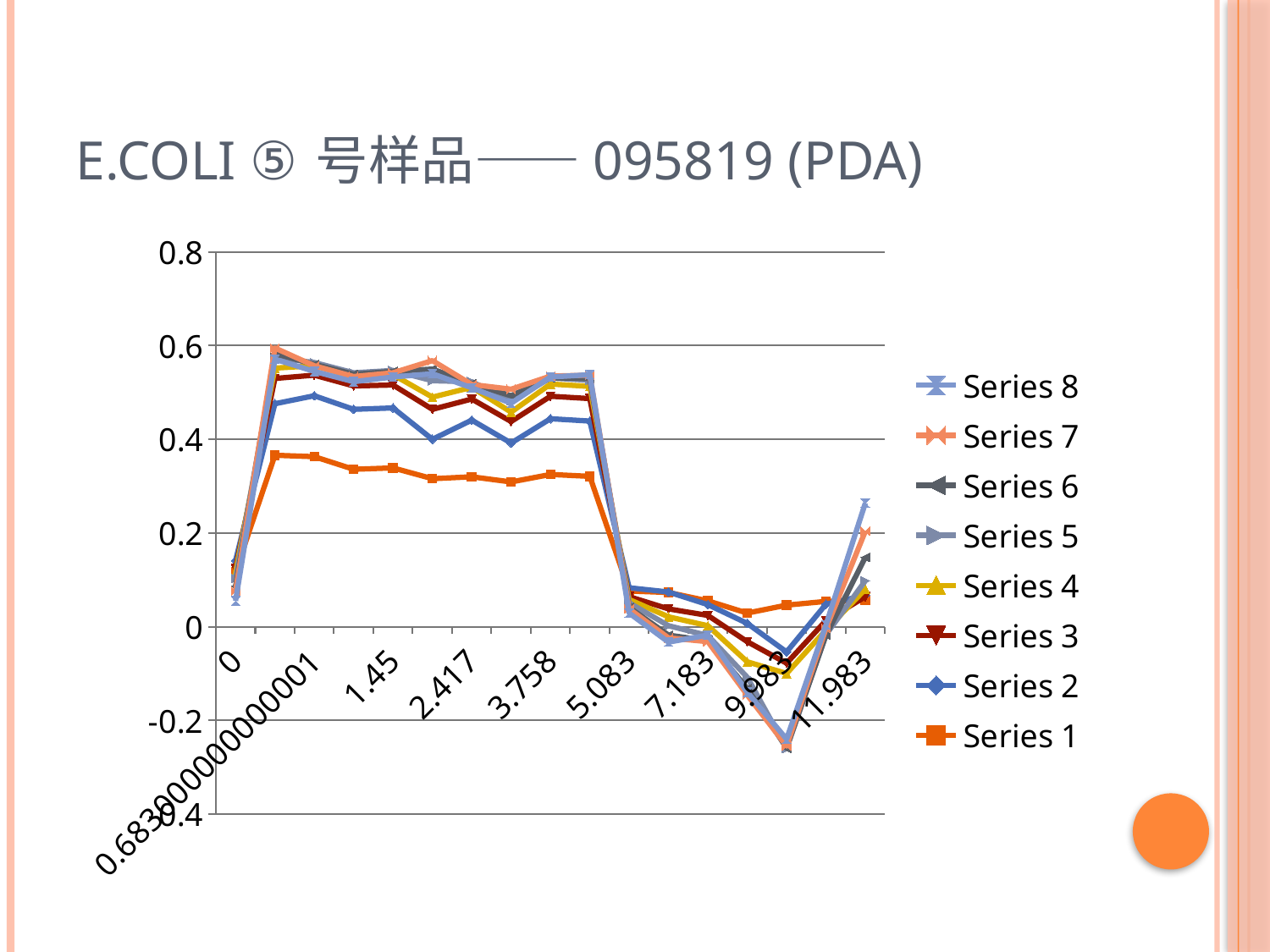
Does the value for Series 1 rise or fall between x = 5.083 and x = 7.183? fall Is the value for Series 7 at x = 9.983 greater or less than -0.2? less How many series does the legend list? 8 What is the title of the slide containing the chart? E.COLI ⑤ 号样品—— 095819 (PDA) Is the value for Series 1 at x = 1.45 greater or less than 0.2? greater At x = 9.983, which is larger: the value for Series 1 or the value for Series 7? Series 1 Which series has the lowest value at x = 1.45? Series 1 Is the value for Series 8 at x = 11.983 greater or less than 0.2? greater Which series is shown in orange with square markers in the legend? Series 1 Which series has the highest value at x = 11.983? Series 8 What kind of chart is shown on the slide? line chart